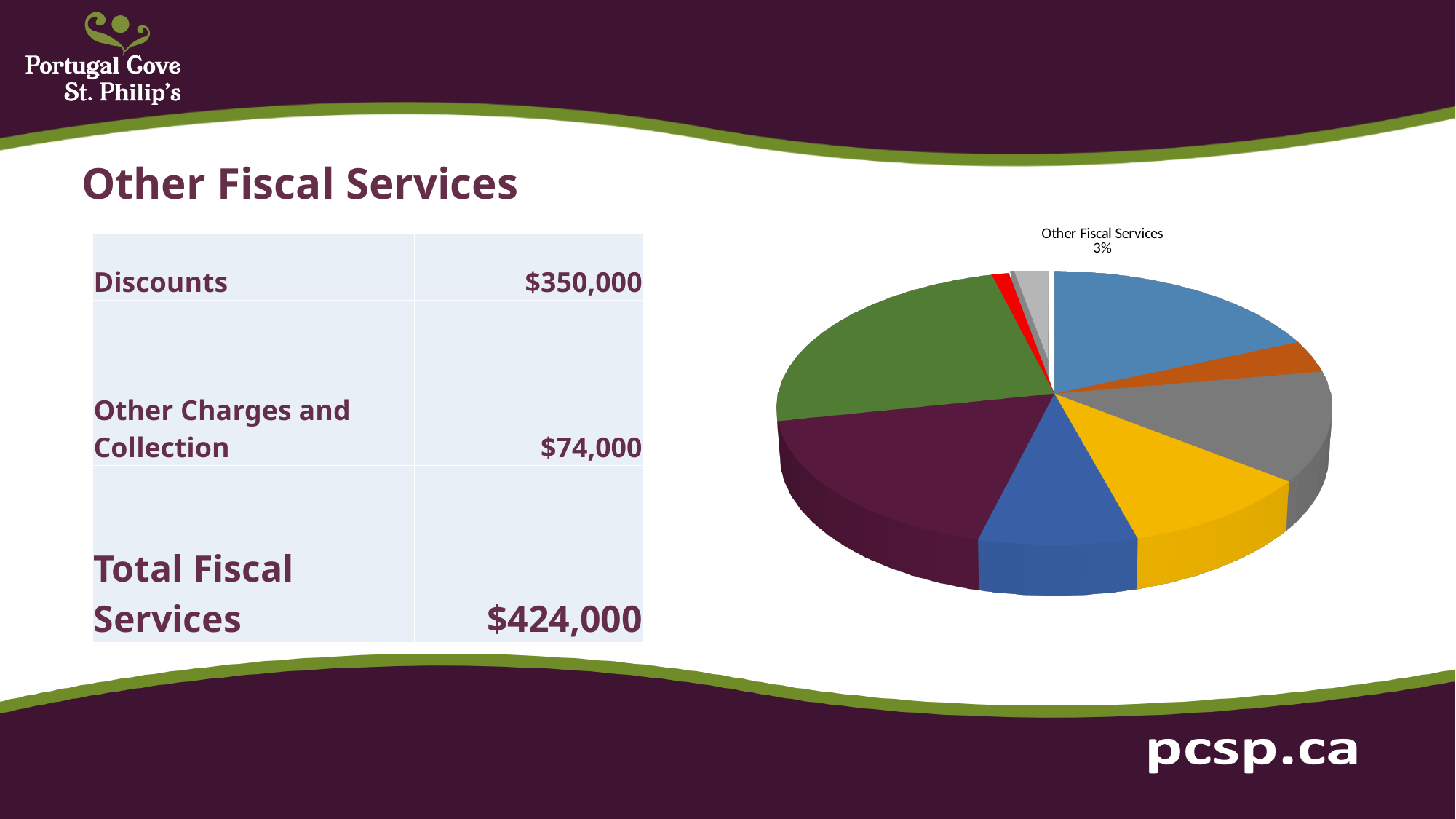
How many slices does the pie chart have? 9 Which slice of the pie chart is labelled with a percentage? Other Fiscal Services What colour is the slice labelled Other Fiscal Services? light gray What share of the pie does the Other Fiscal Services slice represent? 3% Is the Other Fiscal Services slice larger or smaller than the purple slice of the pie? smaller Is the share for Other Fiscal Services greater or less than 10%? less What kind of chart is shown on the slide? pie chart